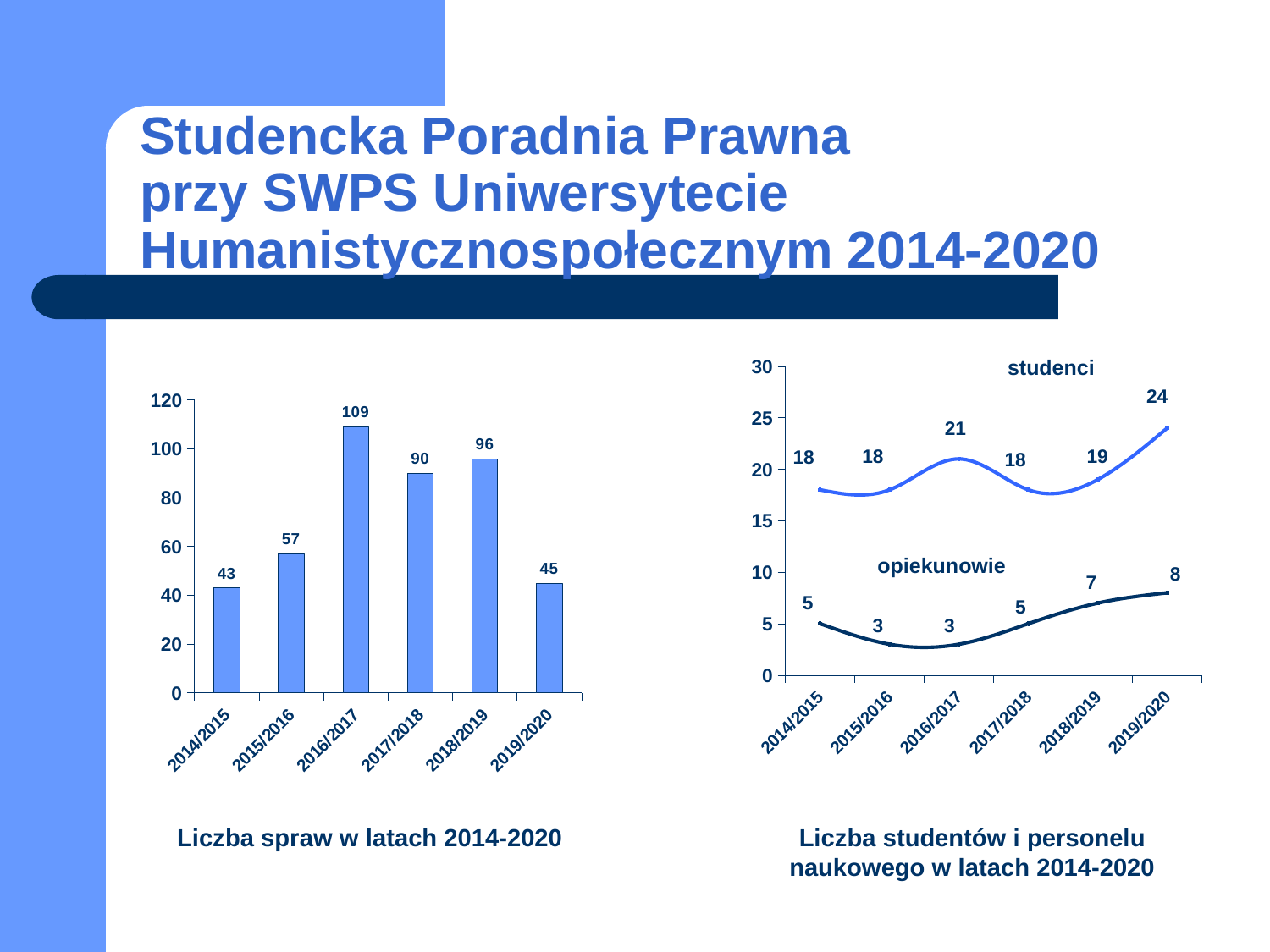
In the left chart (Liczba spraw w latach 2014-2020), which year has the lowest value? 2014/2015 In the right chart (Liczba studentów i personelu naukowego), which is larger in 2017/2018: studenci or opiekunowie? studenci In the right chart (Liczba studentów i personelu naukowego), how many series are plotted? 2 In the left chart (Liczba spraw w latach 2014-2020), what is the value for 2016/2017? 109 In the right chart (Liczba studentów i personelu naukowego), what is the value for opiekunowie in 2015/2016? 3 What kind of chart is the left chart (Liczba spraw w latach 2014-2020)? bar chart In the right chart (Liczba studentów i personelu naukowego), what is the value for studenci in 2019/2020? 24 In the right chart (Liczba studentów i personelu naukowego), what is the difference between studenci and opiekunowie in 2016/2017? 18 In the left chart (Liczba spraw w latach 2014-2020), what is the difference between the values for 2018/2019 and 2019/2020? 51 In the left chart (Liczba spraw w latach 2014-2020), how many years are shown on the x axis? 6 In the left chart (Liczba spraw w latach 2014-2020), which year has the highest value? 2016/2017 In the right chart (Liczba studentów i personelu naukowego), does the opiekunowie series rise or fall from 2016/2017 to 2019/2020? rise